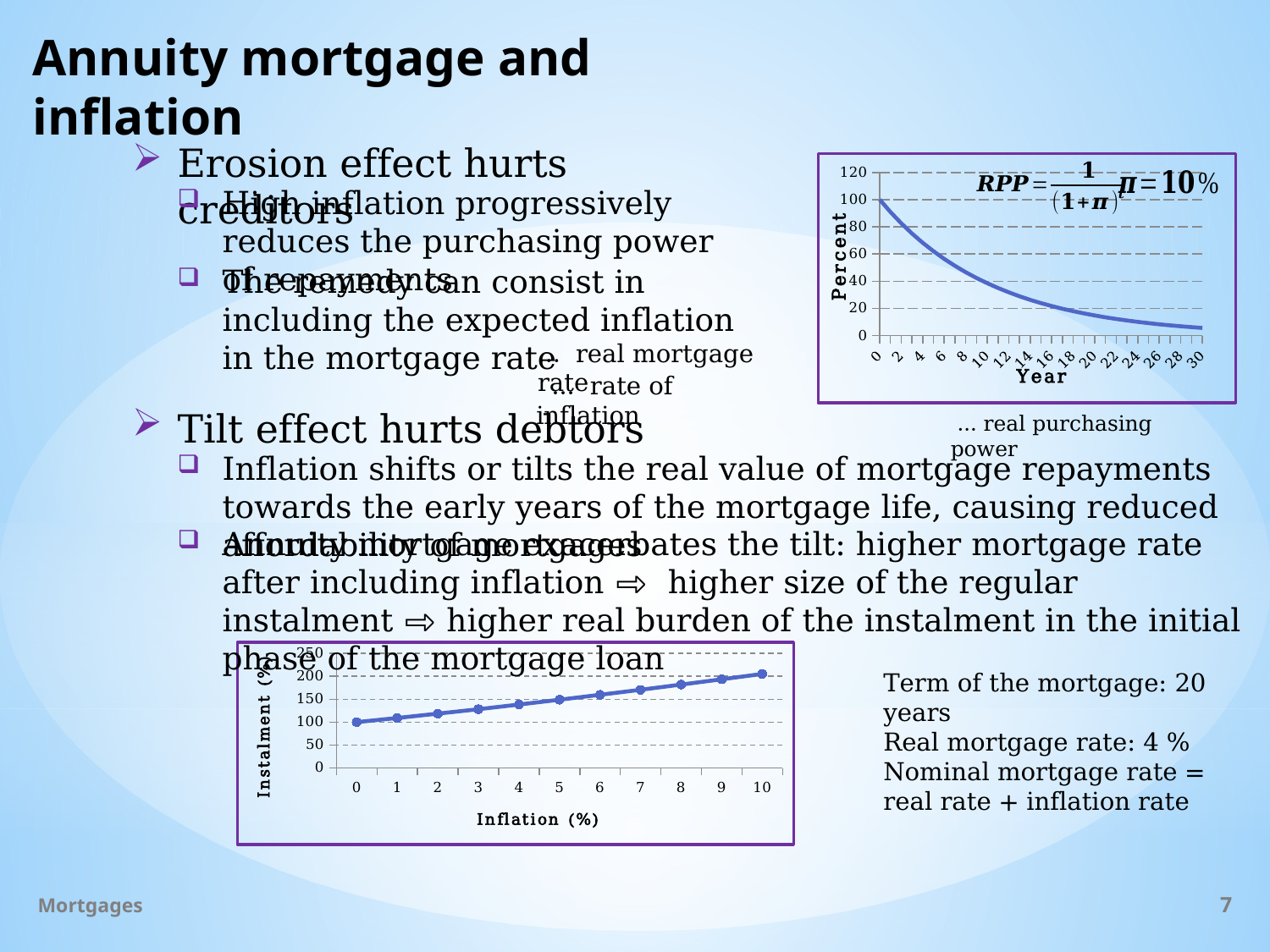
In the top-right chart (Percent vs Year), is the value at year 10 greater or less than 60? less In the bottom-left chart (Instalment vs Inflation), how many data points are plotted? 11 In the top-right chart (Percent vs Year), is the value at year 30 greater or less than 20? less What kind of chart is the chart in the top right of the slide (Percent vs Year)? line chart In the bottom-left chart (Instalment vs Inflation), what is the instalment value at 0% inflation? 100 In the bottom-left chart (Instalment vs Inflation), what is the label of the y axis? Instalment (%) In the bottom-left chart (Instalment vs Inflation), do the values rise or fall as inflation increases? rise In the bottom-left chart (Instalment vs Inflation), is the value at 10% inflation greater or less than 150? greater In the top-right chart (Percent vs Year), what is the value at year 0? 100 In the top-right chart (Percent vs Year), do the values rise or fall as the year increases? fall In the top-right chart (Percent vs Year), what is the label of the x axis? Year What kind of chart is the chart in the bottom left of the slide (Instalment vs Inflation)? line chart